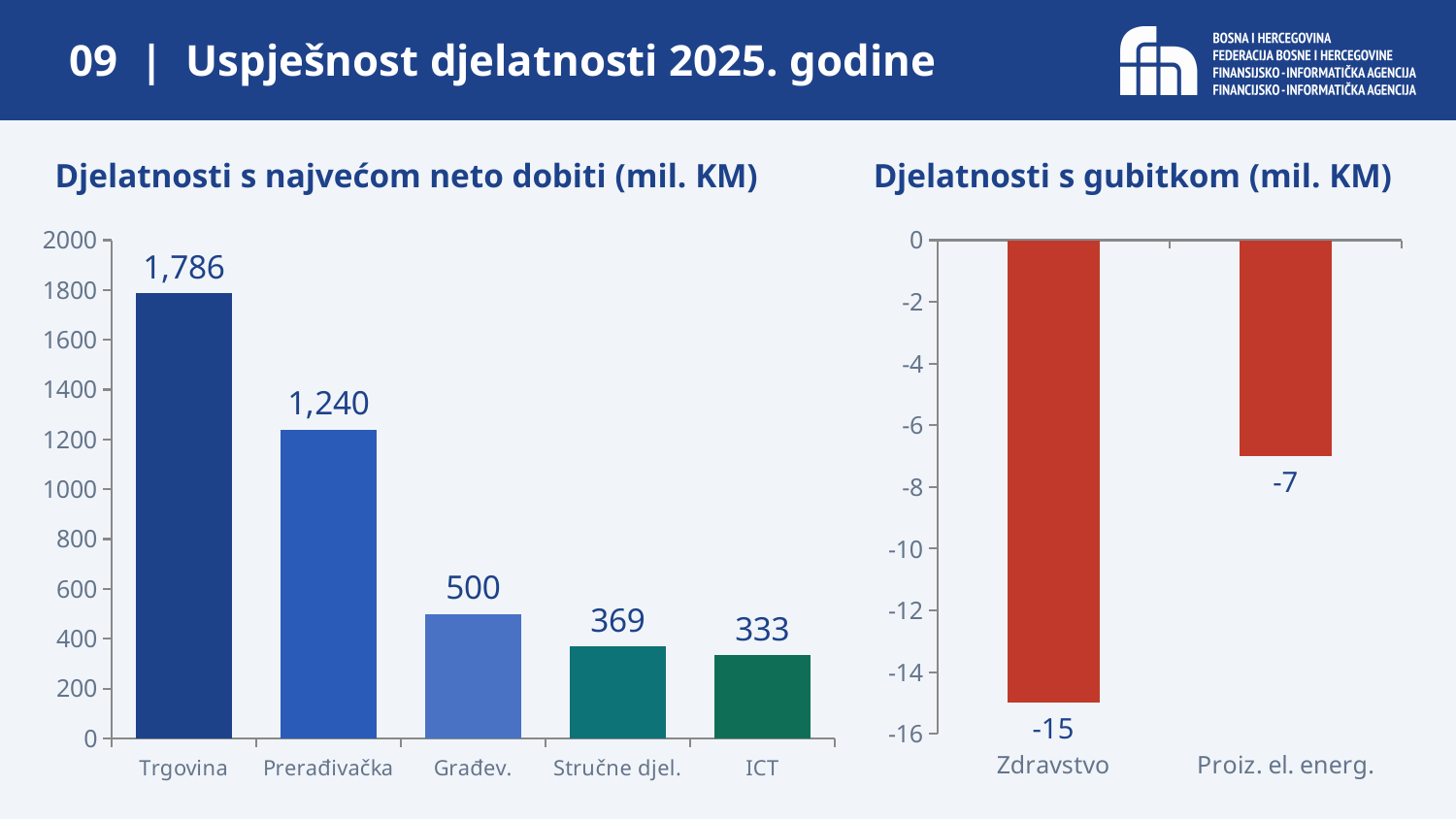
In the chart 'Djelatnosti s najvećom neto dobiti (mil. KM)', what is the value for Građev.? 500 In the chart 'Djelatnosti s najvećom neto dobiti (mil. KM)', what is the difference between Trgovina and Prerađivačka? 546 In the chart 'Djelatnosti s najvećom neto dobiti (mil. KM)', what is the value for Trgovina? 1,786 In the chart 'Djelatnosti s gubitkom (mil. KM)', how many categories are shown? 2 In the chart 'Djelatnosti s gubitkom (mil. KM)', what is the value for Zdravstvo? -15 In the chart 'Djelatnosti s gubitkom (mil. KM)', what is the value for Proiz. el. energ.? -7 In the chart 'Djelatnosti s najvećom neto dobiti (mil. KM)', which category has the lowest value? ICT In the chart 'Djelatnosti s najvećom neto dobiti (mil. KM)', do the values rise or fall from left to right? fall In the chart 'Djelatnosti s najvećom neto dobiti (mil. KM)', which category has the highest value? Trgovina In the chart 'Djelatnosti s najvećom neto dobiti (mil. KM)', how many categories are shown? 5 In the chart 'Djelatnosti s najvećom neto dobiti (mil. KM)', which is larger, Stručne djel. or ICT? Stručne djel. What kind of chart is 'Djelatnosti s gubitkom (mil. KM)'? bar chart